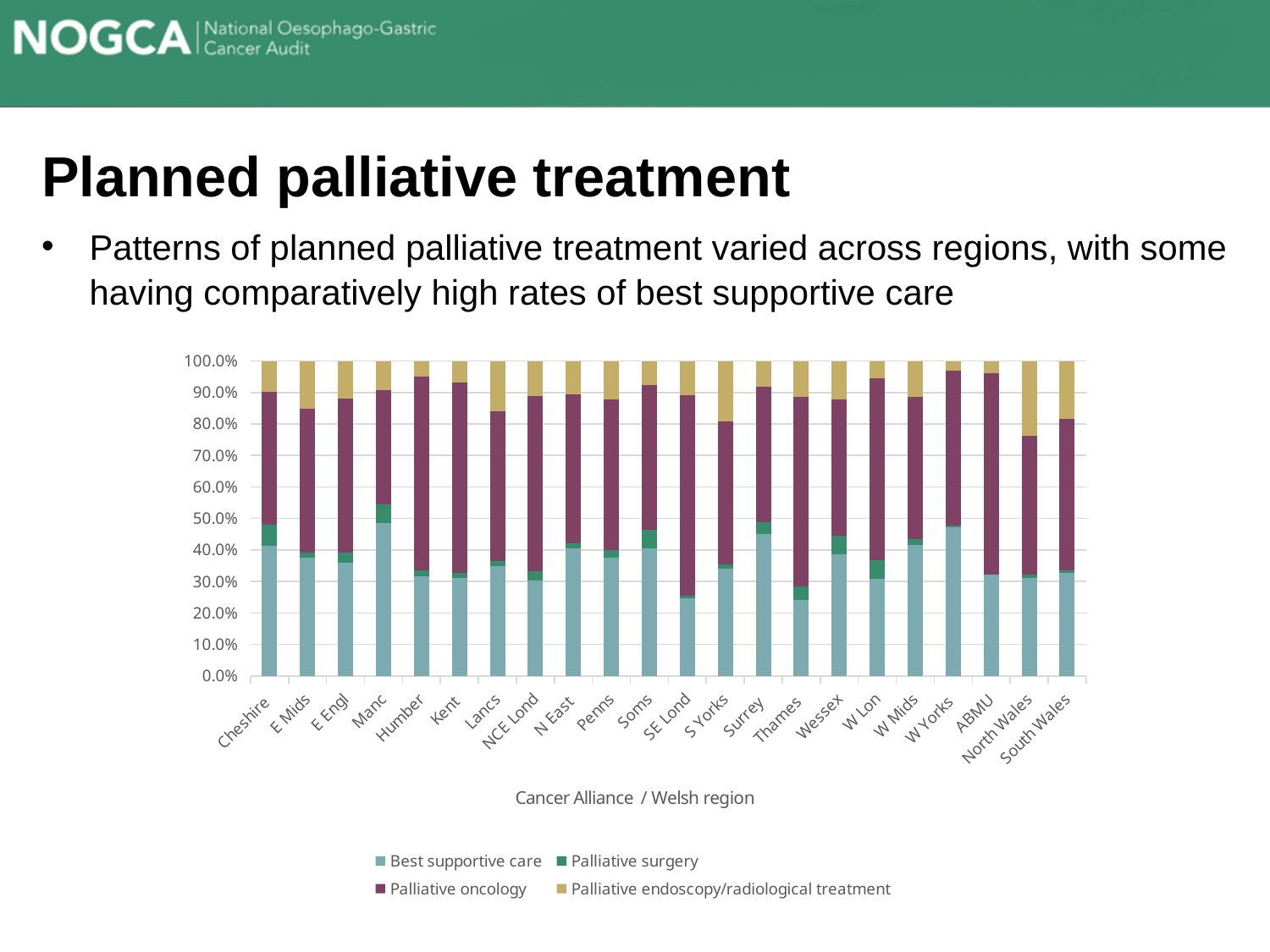
What does each stacked bar total? 100.0% Which region has the largest share of Palliative endoscopy/radiological treatment? North Wales What is the title of the x axis? Cancer Alliance / Welsh region What kind of chart is shown on the slide? Stacked bar chart How many series does the legend list? 4 Is the Best supportive care value for SE Lond greater or less than 30%? less Is the Best supportive care value for W Yorks greater or less than 40%? greater Is the Best supportive care value for Thames greater or less than 30%? less Which has the larger Best supportive care share, Manc or SE Lond? Manc How many regions are shown along the x axis? 22 Which series is shown in yellow in the legend? Palliative endoscopy/radiological treatment